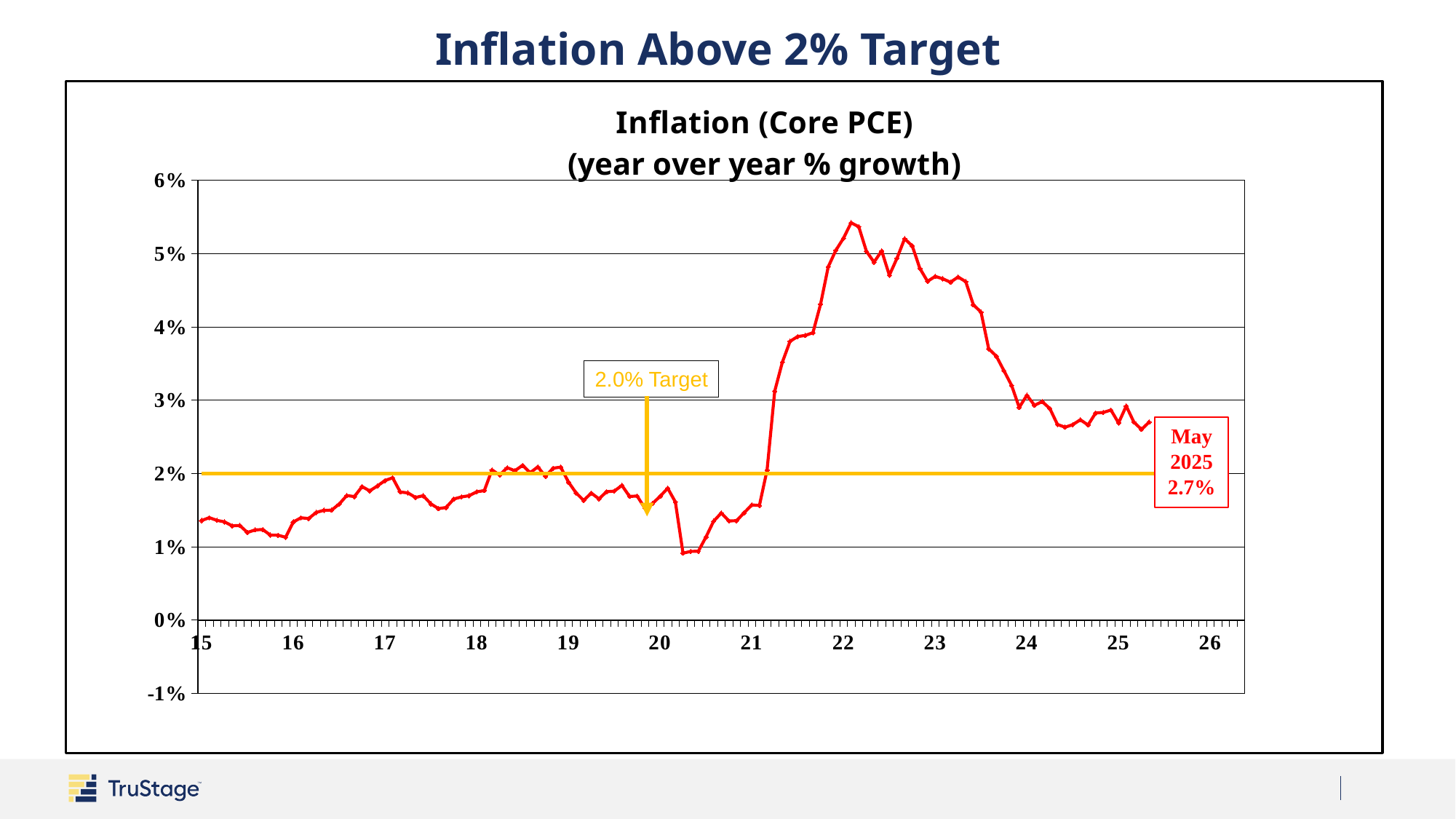
Around which year does Core PCE inflation reach its highest point on the chart? 22 Is the May 2025 Core PCE inflation value greater or less than the 2.0% target? greater Does Core PCE inflation rise or fall between 2022 and 2024? fall Is the Core PCE inflation value at the start of 2022 greater or less than 5%? greater What target level is marked by the horizontal yellow line? 2.0% Target Does Core PCE inflation rise or fall between 2021 and 2022? rise What is the Core PCE inflation value labeled for May 2025? 2.7% What type of chart is used to show Core PCE inflation? line chart Is the Core PCE inflation value at the start of 2015 greater or less than 2%? less Is the Core PCE inflation value in early 2020 (around the dip after 20) greater or less than 1%? less What is the title of the chart? Inflation (Core PCE) (year over year % growth) What is the highest value shown on the vertical axis? 6%